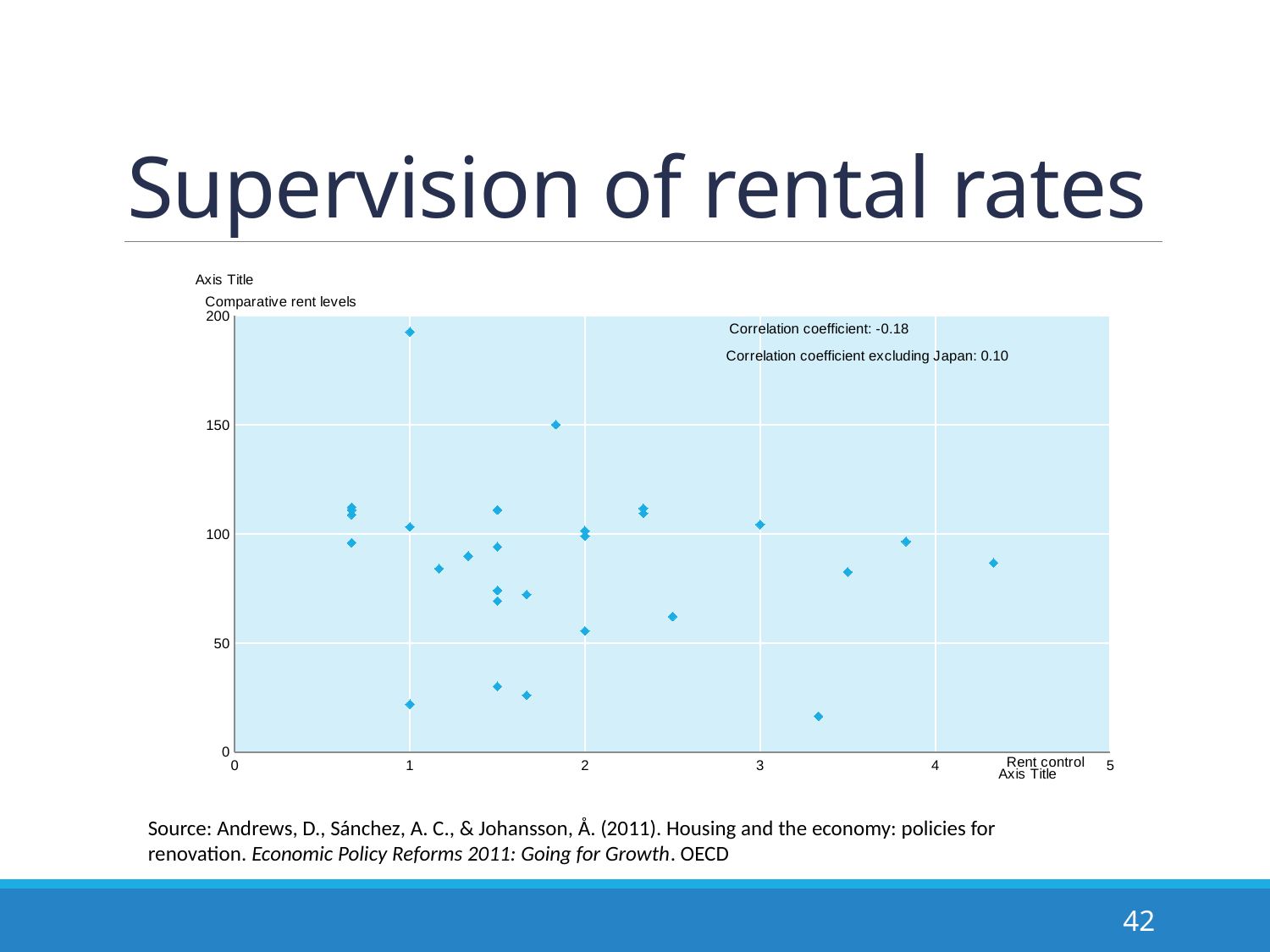
Is the point plotted at rent control 3 greater or less than 50? greater Is the highest comparative rent level point on the chart greater or less than 150? greater What correlation coefficient is stated on the chart when Japan is excluded? 0.10 What kind of chart is shown on the slide? scatter chart Is the lowest of the points plotted at rent control 2 greater or less than 100? less How many points are plotted at a rent control value of 1? 3 At which rent control value on the x axis does the highest comparative rent level point occur? 1 What correlation coefficient is stated on the chart for all points? -0.18